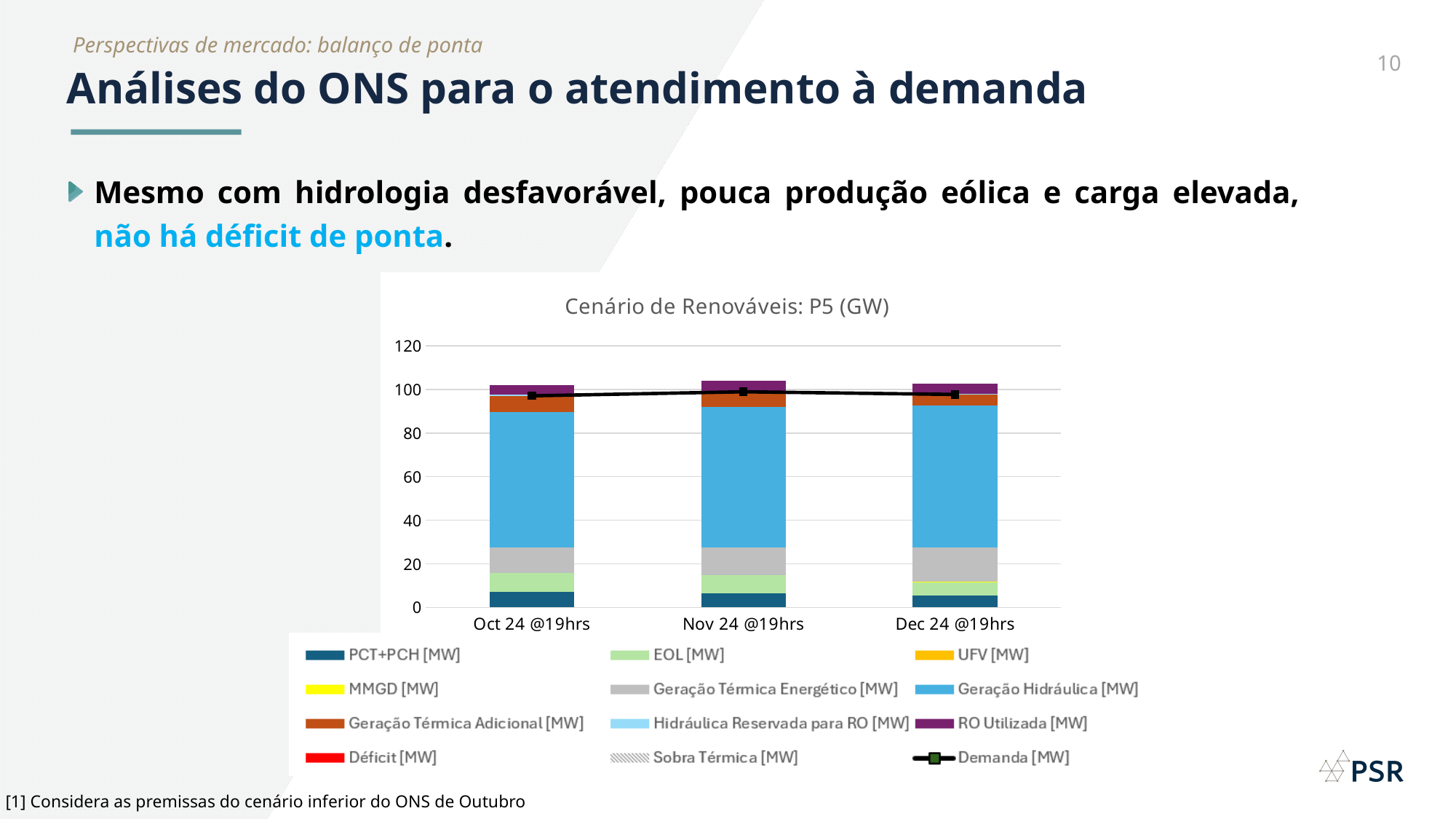
In which category does the Demanda line reach its highest value? Nov 24 @19hrs How many series does the chart legend list? 12 Which category is shown first on the x axis? Oct 24 @19hrs What kind of chart is shown on the slide? combination stacked bar and line chart How many categories are shown on the x axis of the chart? 3 Is the Demanda value for Dec 24 @19hrs greater or less than 80? greater Is the Demanda value for Oct 24 @19hrs greater or less than 100? less What is the title of the chart? Cenário de Renováveis: P5 (GW) Is the total height of the stacked bar for Dec 24 @19hrs greater or less than 120? less